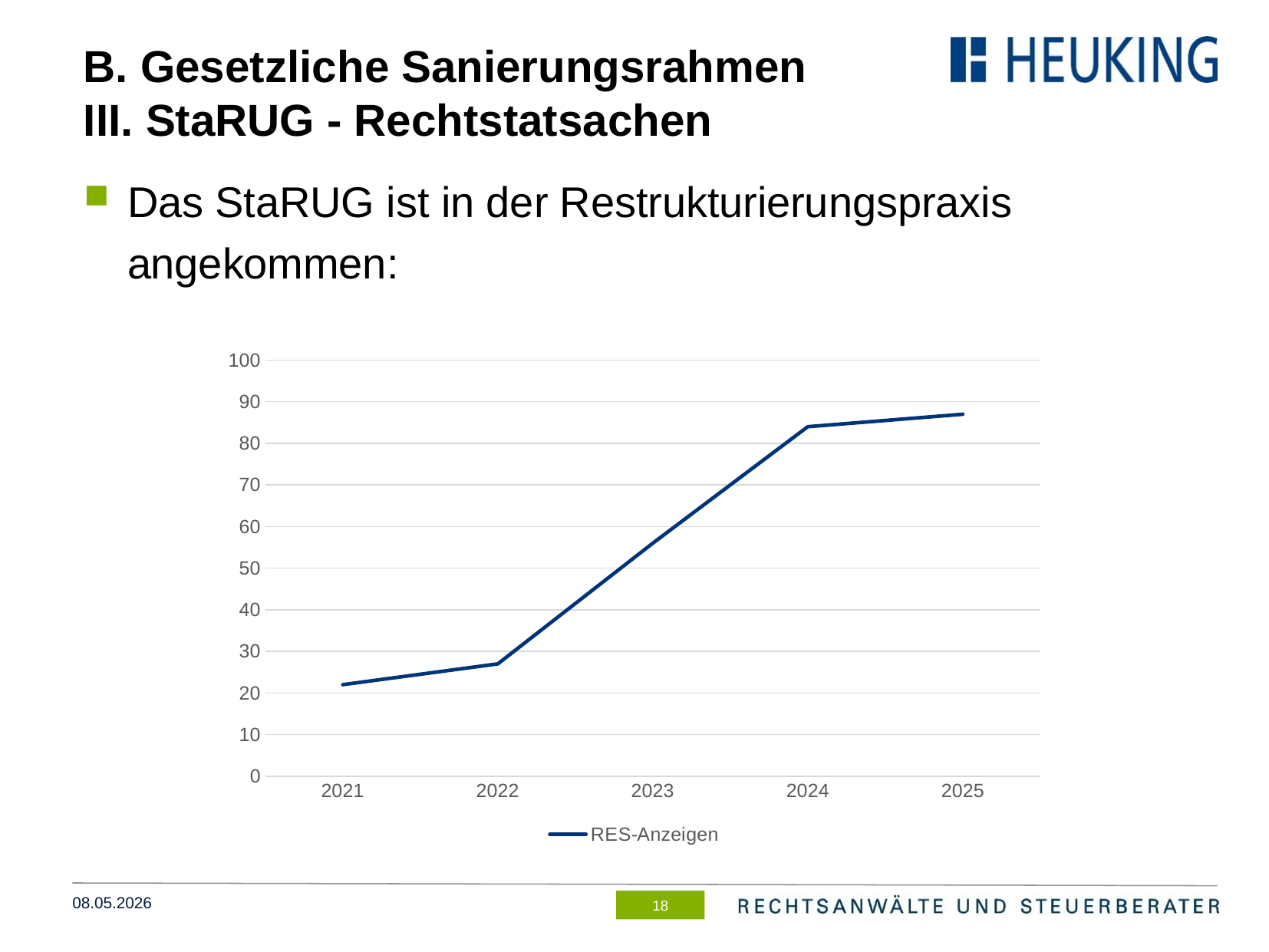
Which is larger, the value for 2021 or the value for 2024? 2024 What kind of chart is shown on the slide? line chart Is the value for 2024 greater or less than 80? greater Which year has the lowest value for RES-Anzeigen? 2021 What is the name of the series shown in the legend? RES-Anzeigen Do the values for RES-Anzeigen rise or fall from 2021 to 2025? rise How many series does the legend list? 1 Is the value for 2021 greater or less than 30? less Is the value for 2023 greater or less than 50? greater How many years are plotted on the x axis? 5 Which is larger, the value for 2022 or the value for 2023? 2023